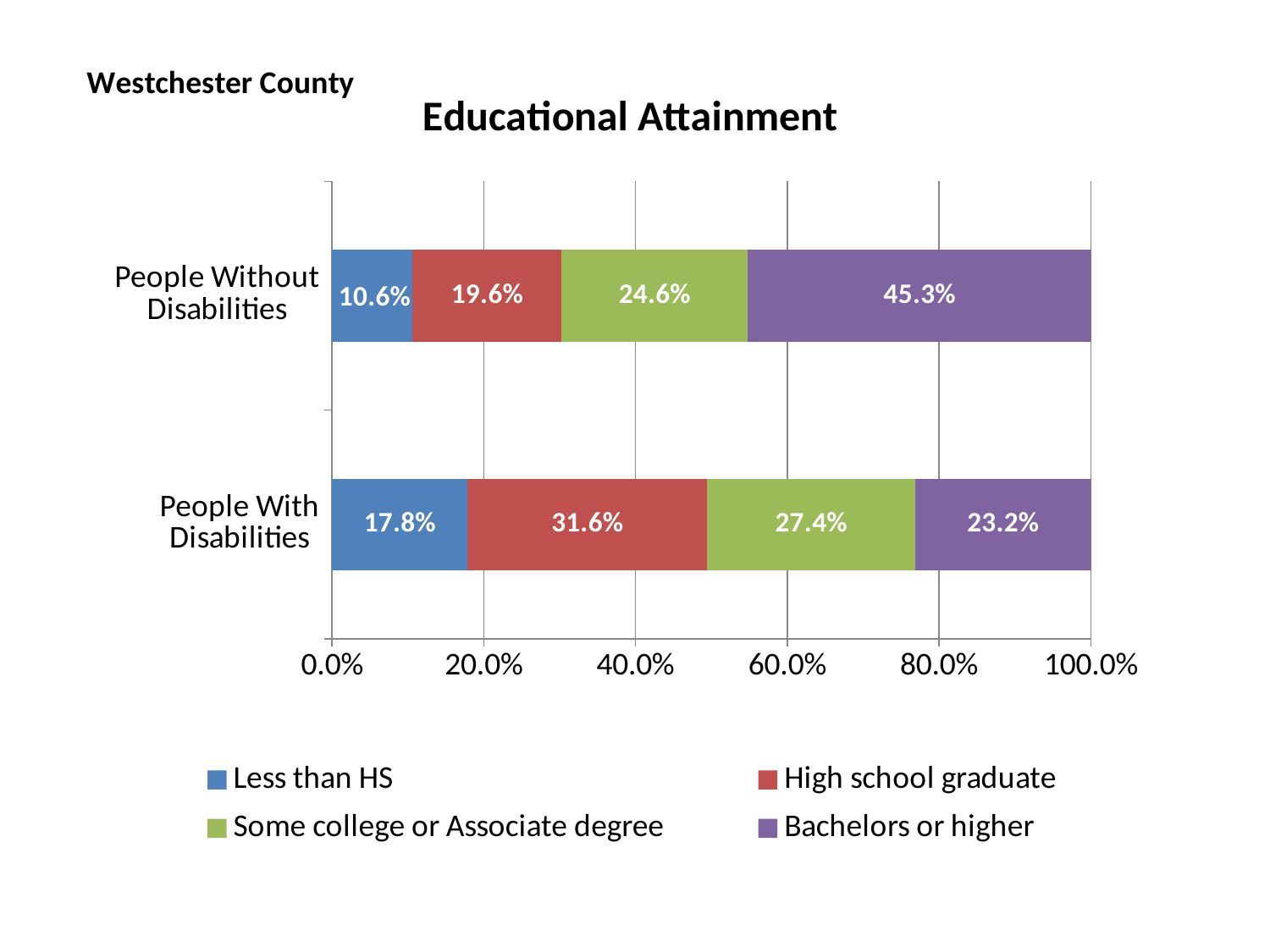
What kind of chart is shown on the slide? Stacked bar chart What percentage of People Without Disabilities are High school graduates? 19.6% How many series does the legend list? 4 What is the title of the chart? Educational Attainment What percentage of People With Disabilities have a Bachelors or higher? 23.2% What is the difference in the Bachelors or higher share between People Without Disabilities and People With Disabilities? 22.1% Which education level has the smallest share among People With Disabilities? Less than HS Which group has a larger High school graduate share, People With Disabilities or People Without Disabilities? People With Disabilities Which education level has the largest share among People Without Disabilities? Bachelors or higher What is the value for Less than HS among People With Disabilities? 17.8% What is the value for Some college or Associate degree among People Without Disabilities? 24.6% How many categories (groups) are shown on the chart? 2